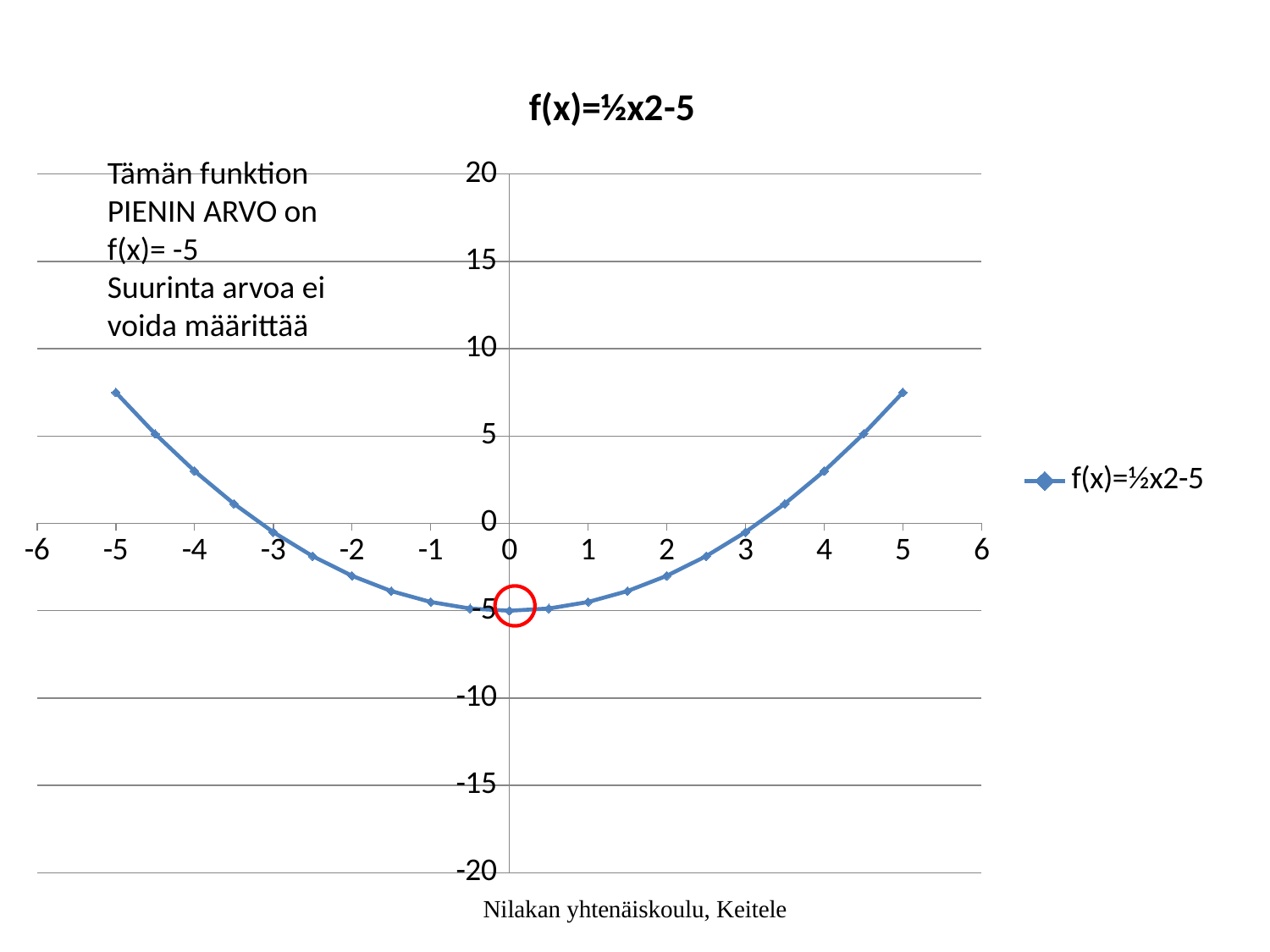
What is the value of f(x) at x = 0? -5 Is the value of f(x) at x = -5 greater or less than 10? less How many series does the legend list? 1 Which has the larger value of f(x): x = -5 or x = -3? x = -5 At which x value does the plotted function reach its lowest point? 0 How many data points are plotted on the curve? 21 Is the value of f(x) at x = 5 greater or less than 5? greater Is the value of f(x) at x = -4 greater or less than 5? less Do the plotted values rise or fall as x increases from 0 to 5? rise What is the title of the chart? f(x)=½x2-5 What kind of chart is shown on the slide? line chart